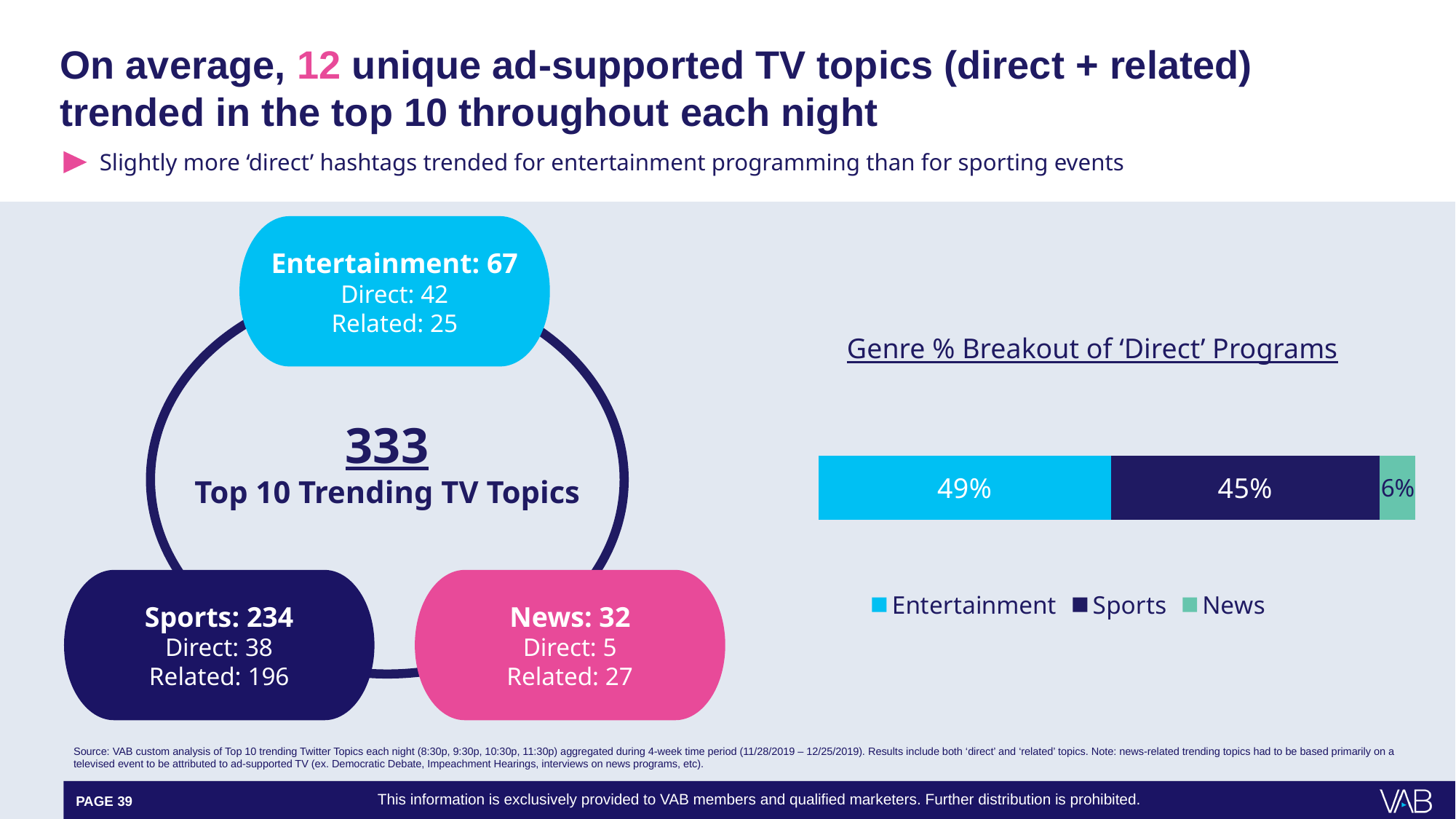
In the 'Genre % Breakout of 'Direct' Programs' chart, what is the difference between the Entertainment and Sports percentages? 4% In the 'Genre % Breakout of 'Direct' Programs' chart, which is larger: Sports or News? Sports How many series does the legend of the 'Genre % Breakout of 'Direct' Programs' chart list? 3 In the 'Genre % Breakout of 'Direct' Programs' chart, what colour is the Sports segment? Dark navy blue In the 'Genre % Breakout of 'Direct' Programs' chart, what is the total of the three segments in the bar? 100% In the 'Genre % Breakout of 'Direct' Programs' chart, what is the value for Sports? 45% In the 'Genre % Breakout of 'Direct' Programs' chart, which genre has the largest share? Entertainment In the circle diagram on the left, what is the total number of Top 10 Trending TV Topics shown in the centre? 333 In the 'Genre % Breakout of 'Direct' Programs' chart, what is the value for News? 6% In the 'Genre % Breakout of 'Direct' Programs' chart, what is the value for Entertainment? 49% What kind of chart is the 'Genre % Breakout of 'Direct' Programs' chart? Stacked bar chart In the 'Genre % Breakout of 'Direct' Programs' chart, which genre has the smallest share? News